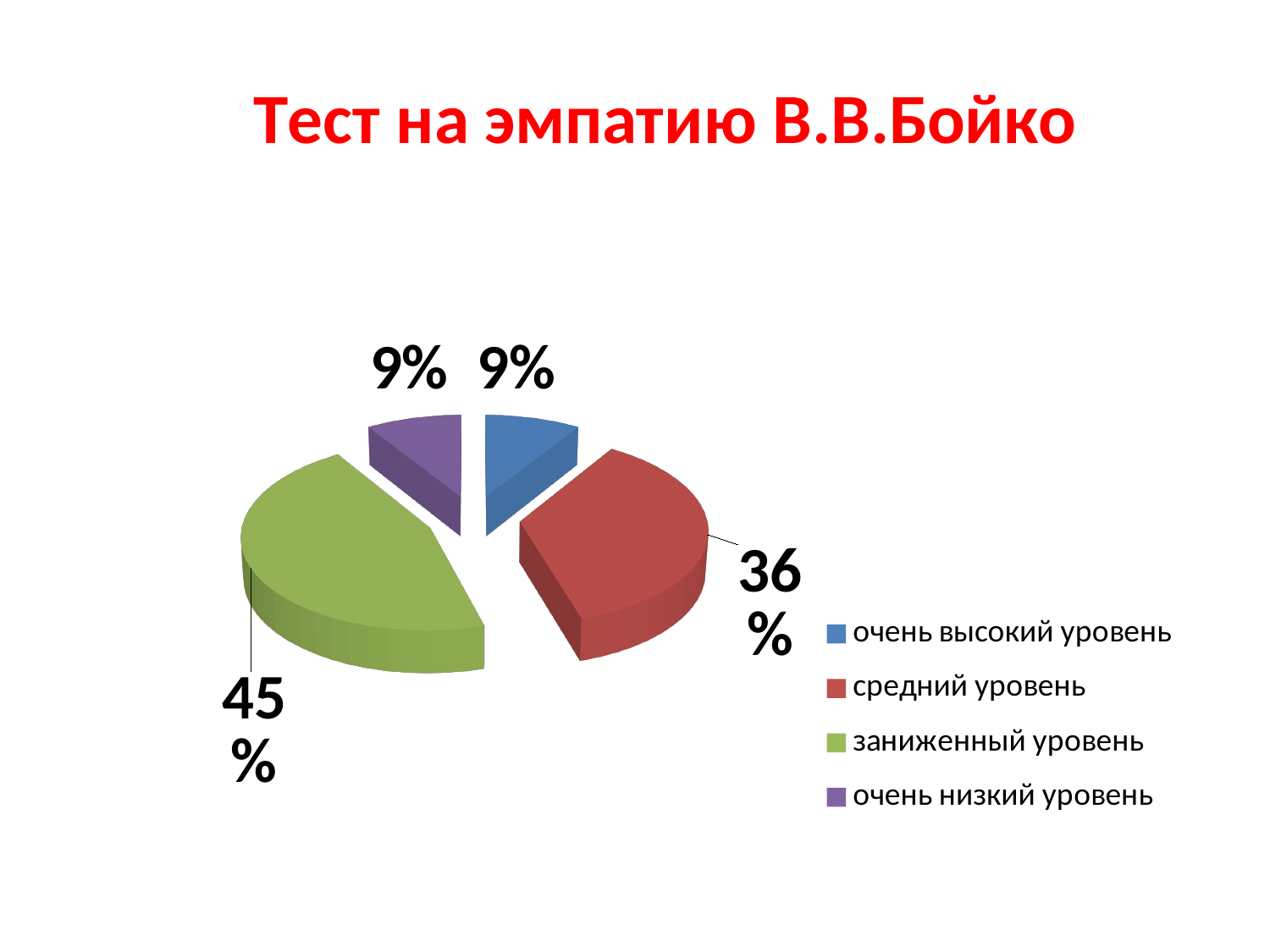
Which category has the largest slice of the pie? заниженный уровень What share of the pie does "заниженный уровень" have? 45% What share of the pie does "очень низкий уровень" have? 9% How many slices does the pie chart have? 4 How many entries does the legend list? 4 What is the difference between the shares of "заниженный уровень" and "средний уровень"? 9% Which is larger, the share of "средний уровень" or the share of "очень низкий уровень"? средний уровень What share of the pie does "средний уровень" have? 36% What colour is the slice for "средний уровень"? red What is the title of the slide containing the pie chart? Тест на эмпатию В.В.Бойко What kind of chart is shown on the slide? pie chart